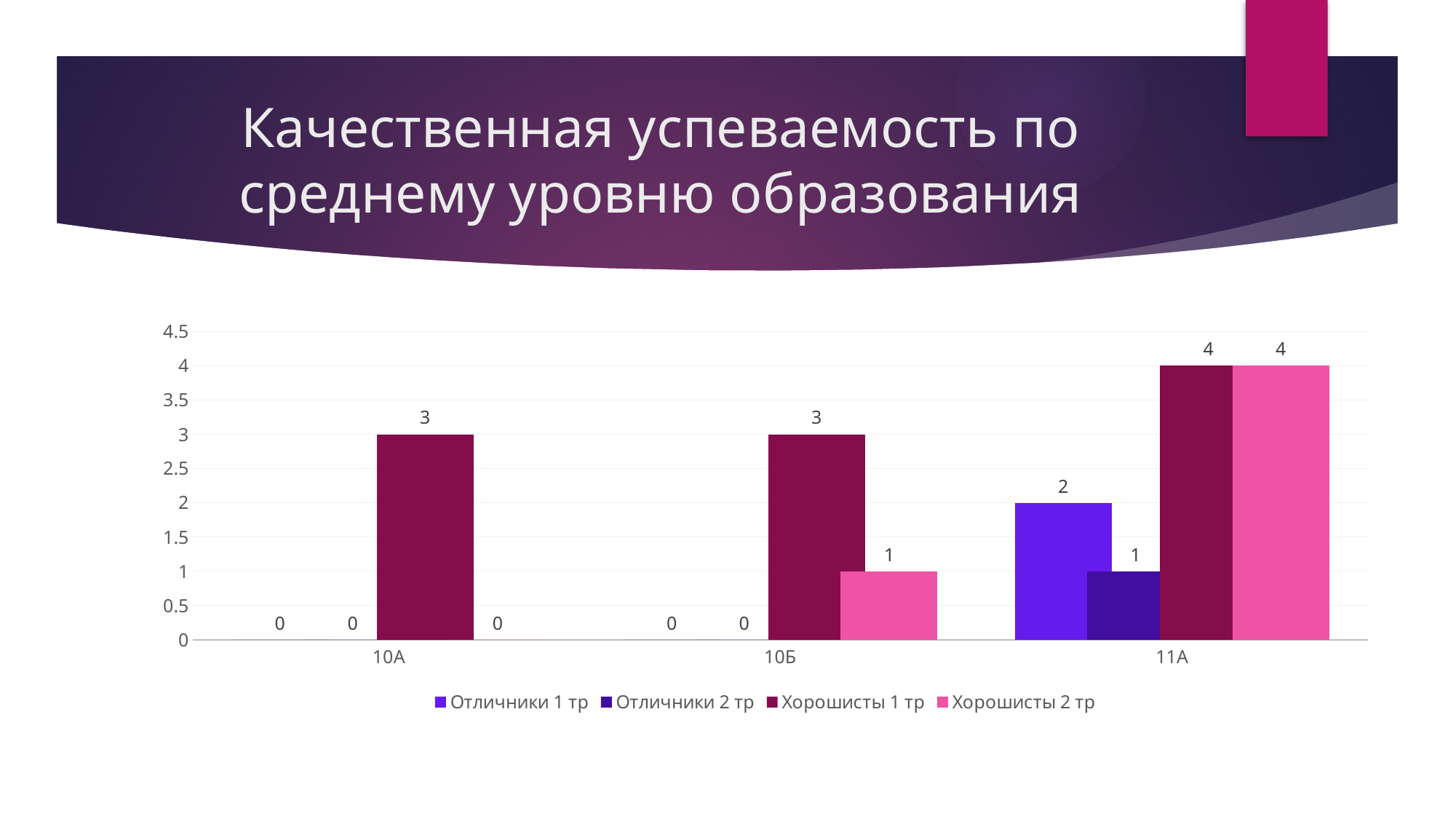
How many series does the legend list? 4 What is the value of Отличники 2 тр for 11А? 1 What is the value of Отличники 1 тр for 11А? 2 Which category has the highest value for Хорошисты 1 тр? 11А What is the value of Хорошисты 2 тр for 10Б? 1 What is the value of Хорошисты 1 тр for 10А? 3 Which category has the lowest value for Хорошисты 2 тр? 10А What is the difference between Хорошисты 1 тр for 11А and Хорошисты 1 тр for 10Б? 1 What is the title of the slide? Качественная успеваемость по среднему уровню образования What kind of chart is shown on the slide? bar chart Which is larger: Отличники 1 тр for 11А or Отличники 2 тр for 11А? Отличники 1 тр for 11А How many categories are shown on the x axis? 3